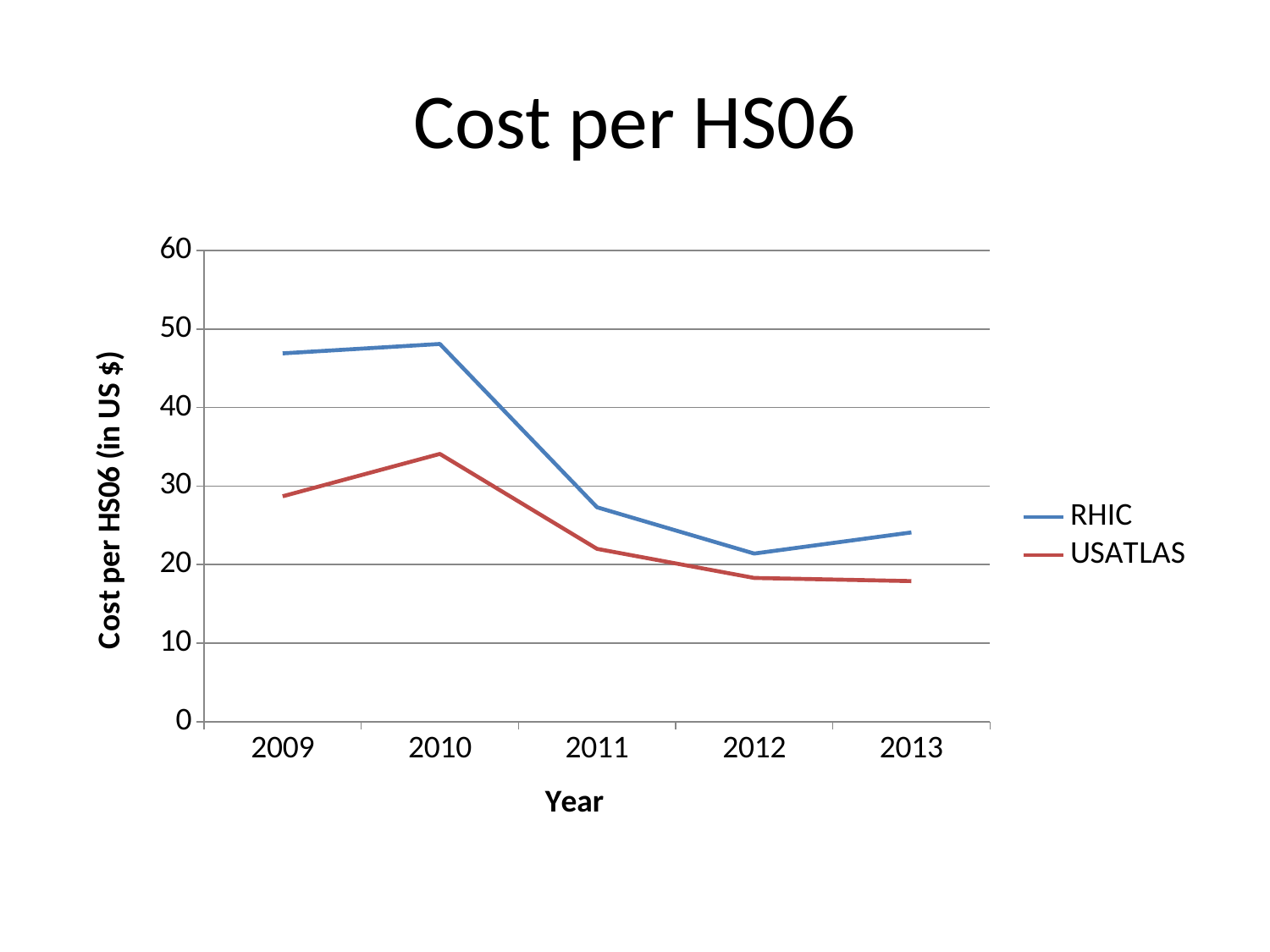
Is the USATLAS value for 2012 greater or less than 20? less What is the label of the y axis? Cost per HS06 (in US $) Is the USATLAS value for 2010 greater or less than 30? greater Is the RHIC value for 2009 greater or less than 40? greater How many series does the legend list? 2 In which year is the RHIC cost per HS06 lowest? 2012 In 2011, which series has the higher cost per HS06, RHIC or USATLAS? RHIC In which year is the USATLAS cost per HS06 highest? 2010 Does the USATLAS line rise or fall from 2010 to 2013? fall How many years are plotted along the x axis? 5 What kind of chart is shown on the slide? line chart